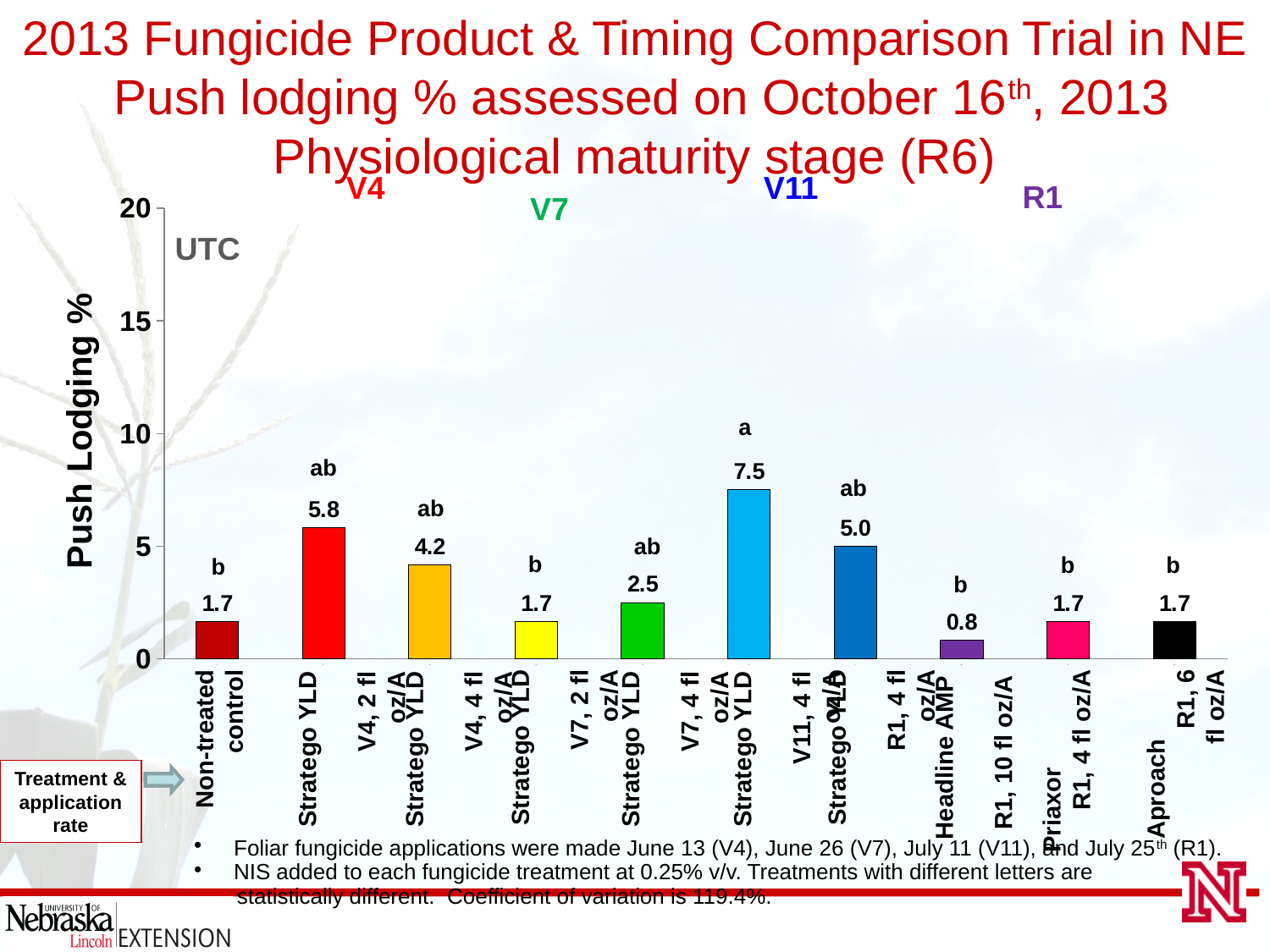
What is the difference in push lodging % between Stratego YLD at V4, 2 fl oz/A and Stratego YLD at V4, 4 fl oz/A? 1.6 What is the push lodging % for Stratego YLD applied at V11, 4 fl oz/A? 7.5 Is the push lodging % for Stratego YLD at V11, 4 fl oz/A greater or less than 10? less What is the push lodging % for Headline AMP at R1, 10 fl oz/A? 0.8 What statistical letter is shown above the Stratego YLD V11, 4 fl oz/A bar? a What type of chart is shown on the slide? bar chart Which has a higher push lodging %: Stratego YLD at V7, 4 fl oz/A or Stratego YLD at R1, 4 fl oz/A? Stratego YLD at R1, 4 fl oz/A What is the push lodging % for Stratego YLD at V4, 2 fl oz/A? 5.8 How many treatment bars are shown in the chart? 10 Which treatment has the highest push lodging %? Stratego YLD V11, 4 fl oz/A Which treatment has the lowest push lodging %? Headline AMP R1, 10 fl oz/A What is the push lodging % for the Non-treated control? 1.7